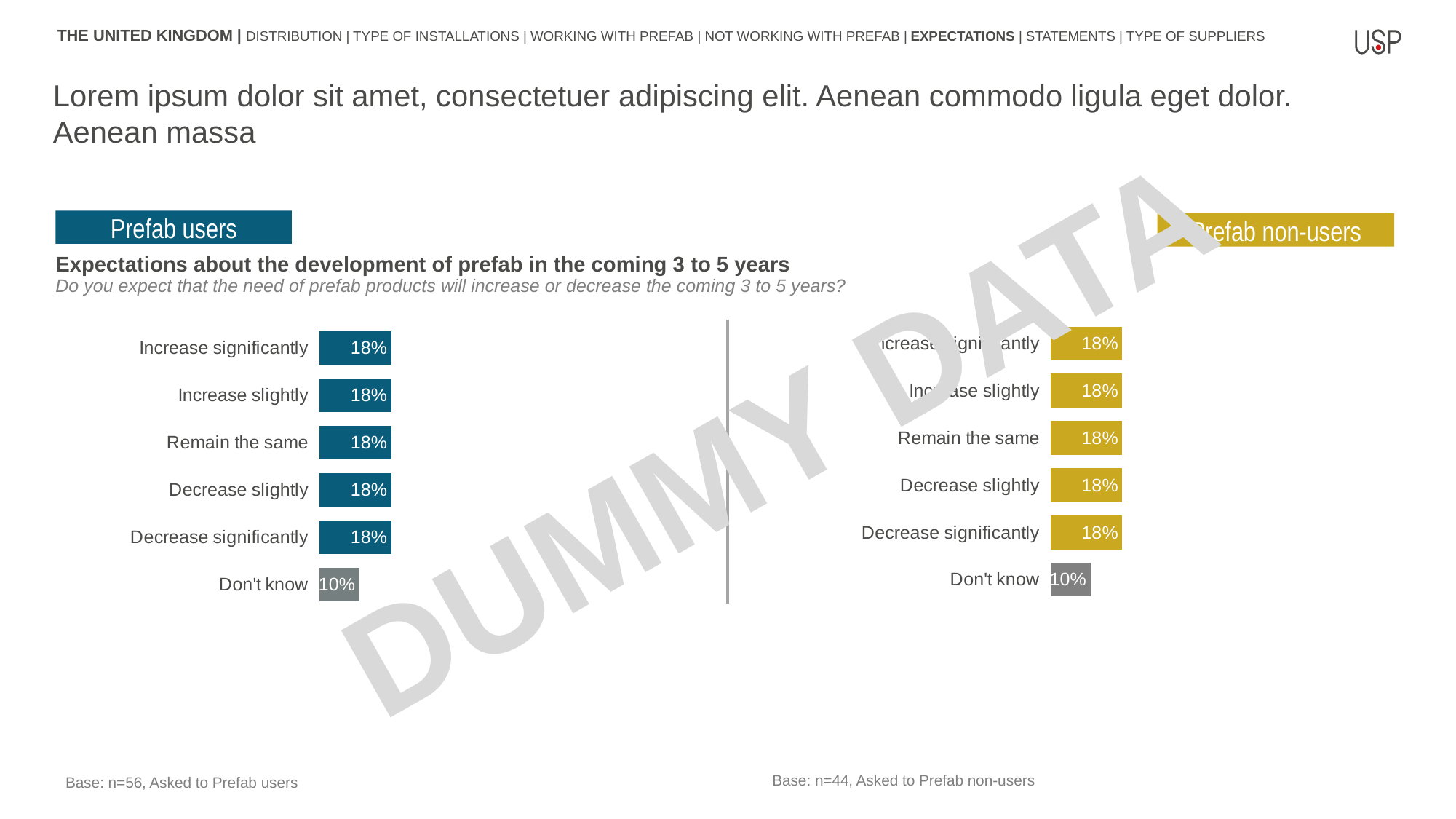
In the Prefab non-users chart on the right, what is the value for Remain the same? 18% In the Prefab users chart on the left, which category has the lowest value? Don't know In the Prefab non-users chart on the right, what is the value for Don't know? 10% In the Prefab users chart on the left, what is the value for Don't know? 10% In the Prefab users chart on the left, what is the difference between the values for Decrease significantly and Don't know? 8 percentage points What is the base (sample size) stated for the Prefab non-users chart on the right? n=44 How many categories are shown in the Prefab users chart on the left? 6 How many categories are shown in the Prefab non-users chart on the right? 6 In the Prefab users chart on the left, what is the value for Increase significantly? 18% In the Prefab non-users chart on the right, which category has the lowest value? Don't know What kind of chart is the Prefab users chart on the left? Bar chart In the Prefab non-users chart on the right, which is larger: the value for Increase slightly or the value for Don't know? Increase slightly